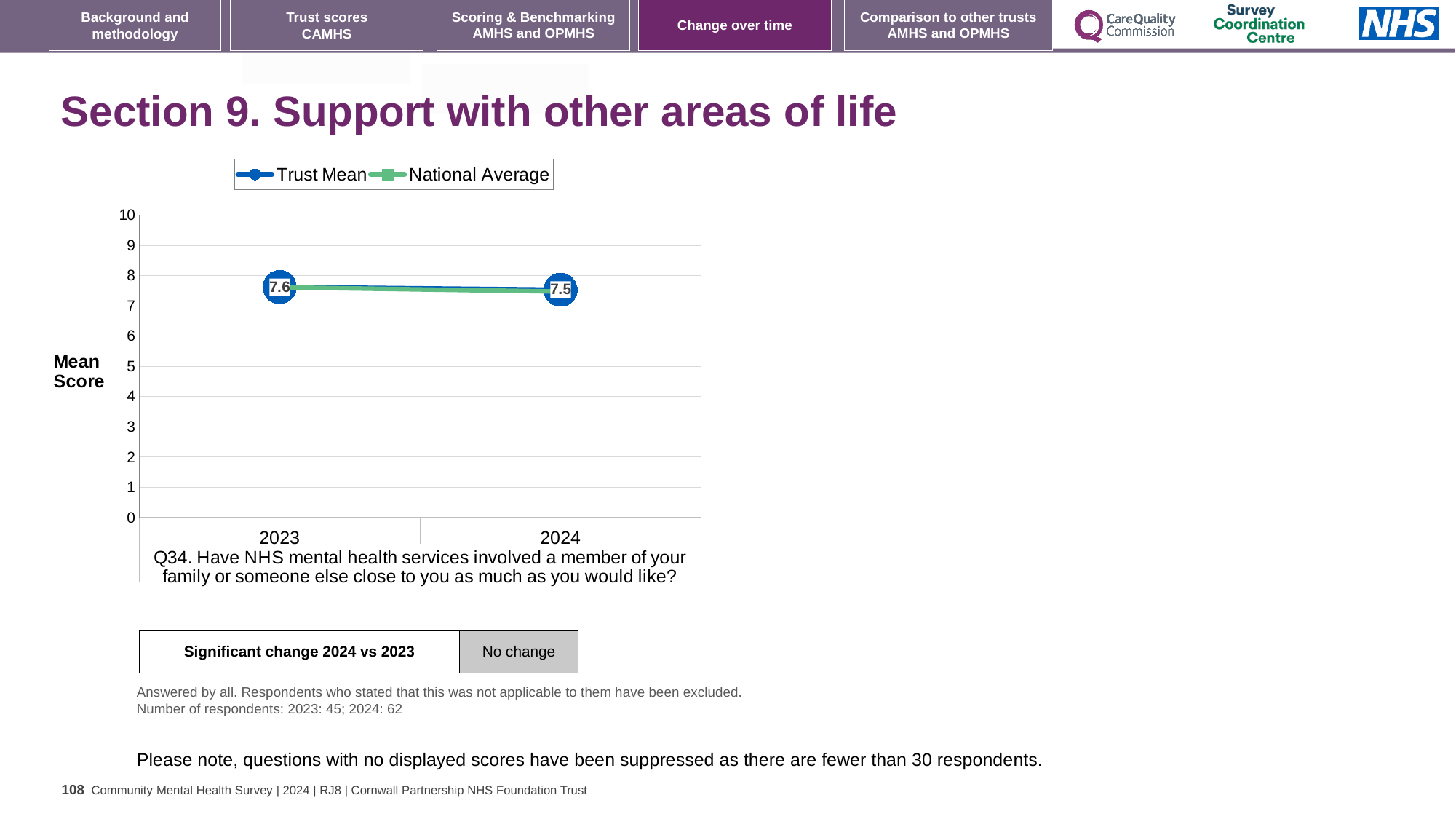
What are the two series named in the chart legend? Trust Mean and National Average What is the label on the vertical axis of the chart? Mean Score Which year has the higher Trust Mean score, 2023 or 2024? 2023 Is the Trust Mean value for 2023 greater or less than 5? greater What is the Trust Mean score for 2024? 7.5 Is the National Average value for 2024 greater or less than 5? greater What is the Trust Mean score for 2023? 7.6 By how much did the Trust Mean score change from 2023 to 2024? 0.1 How many series does the chart legend list? 2 How many years are plotted on the x axis of the chart? 2 Does the Trust Mean score rise or fall from 2023 to 2024? fall What kind of chart is shown on the slide? line chart